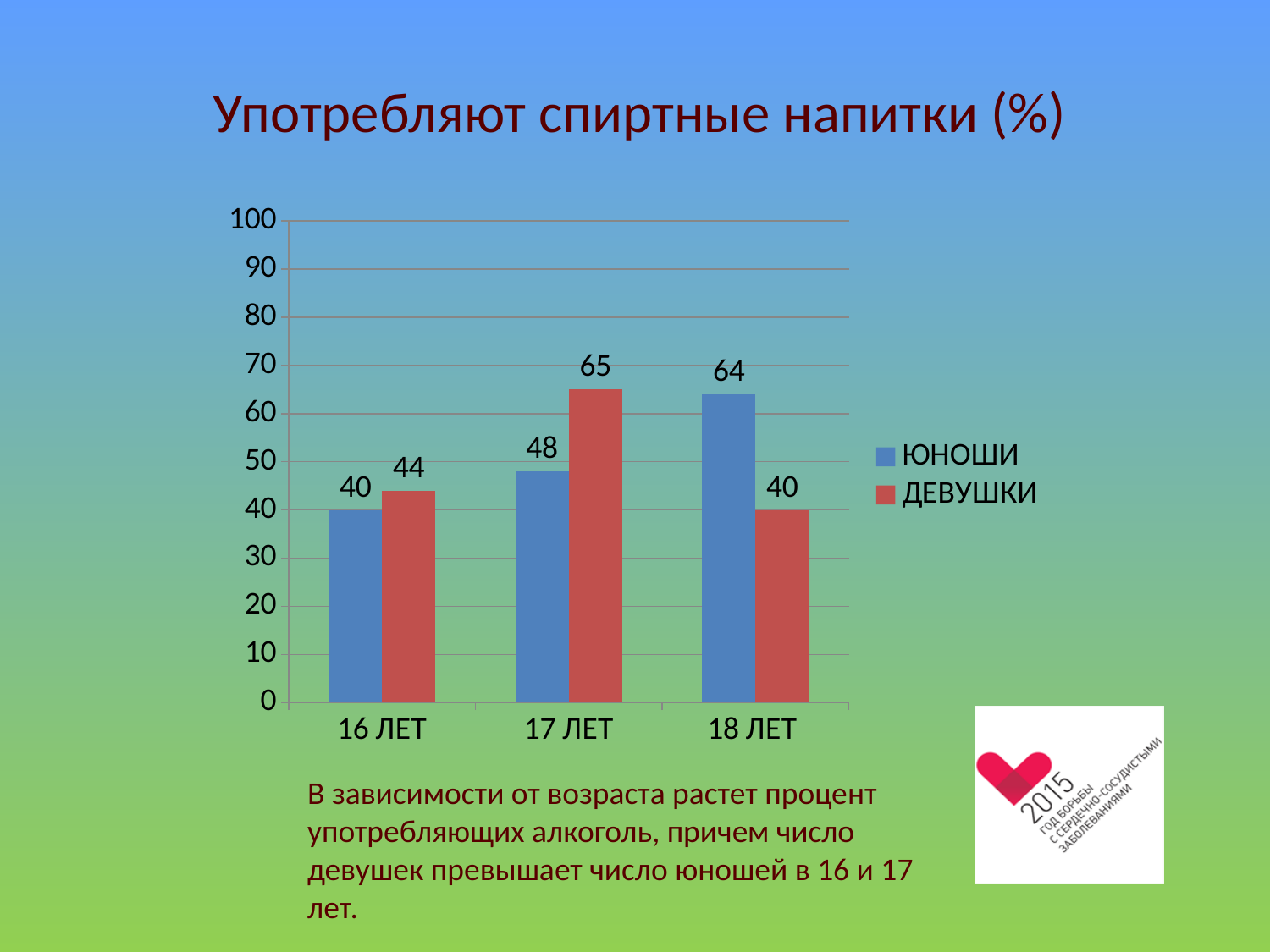
Is the value for ДЕВУШКИ at 16 ЛЕТ greater or less than 50? less Which age category has the lowest value for ДЕВУШКИ? 18 ЛЕТ At 18 ЛЕТ, which is larger: ЮНОШИ or ДЕВУШКИ? ЮНОШИ What kind of chart is shown on the slide? bar chart What is the value for ЮНОШИ at 16 ЛЕТ? 40 How many series does the legend list? 2 Do the values for ЮНОШИ rise or fall from 16 ЛЕТ to 18 ЛЕТ? rise What is the value for ДЕВУШКИ at 17 ЛЕТ? 65 Which age category has the highest value for ЮНОШИ? 18 ЛЕТ What is the value for ЮНОШИ at 18 ЛЕТ? 64 How many age categories are shown on the x axis? 3 What is the difference between ДЕВУШКИ and ЮНОШИ at 17 ЛЕТ? 17